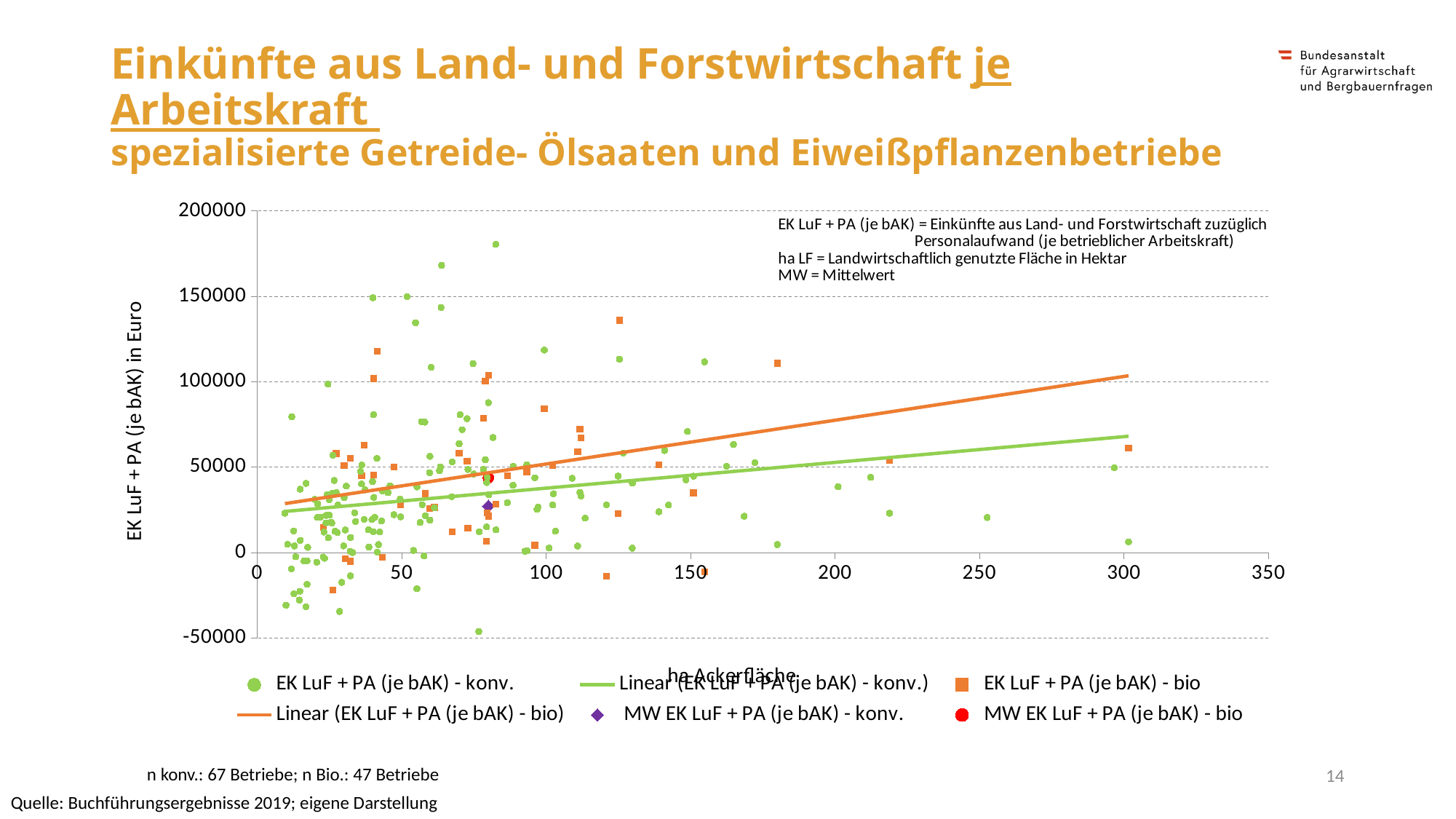
How many series does the legend list? 6 Does the linear trend line for EK LuF + PA (je bAK) - bio rise or fall as ha Ackerfläche increases? rise How many Bio-Betriebe (n Bio.) are included in the chart? 47 Betriebe What is the label of the y axis? EK LuF + PA (je bAK) in Euro Which is higher, the MW EK LuF + PA (je bAK) - bio point or the MW EK LuF + PA (je bAK) - konv. point? MW EK LuF + PA (je bAK) - bio What kind of chart is shown on the slide? scatter chart What is the label of the x axis? ha Ackerfläche Is the value of the MW EK LuF + PA (je bAK) - konv. point greater or less than 50000? less How many konventionelle Betriebe (n konv.) are included in the chart? 67 Betriebe Does the linear trend line for EK LuF + PA (je bAK) - konv. rise or fall as ha Ackerfläche increases? rise Which series contains the single highest point in the chart? EK LuF + PA (je bAK) - konv. Is the value of the MW EK LuF + PA (je bAK) - bio point greater or less than 0? greater